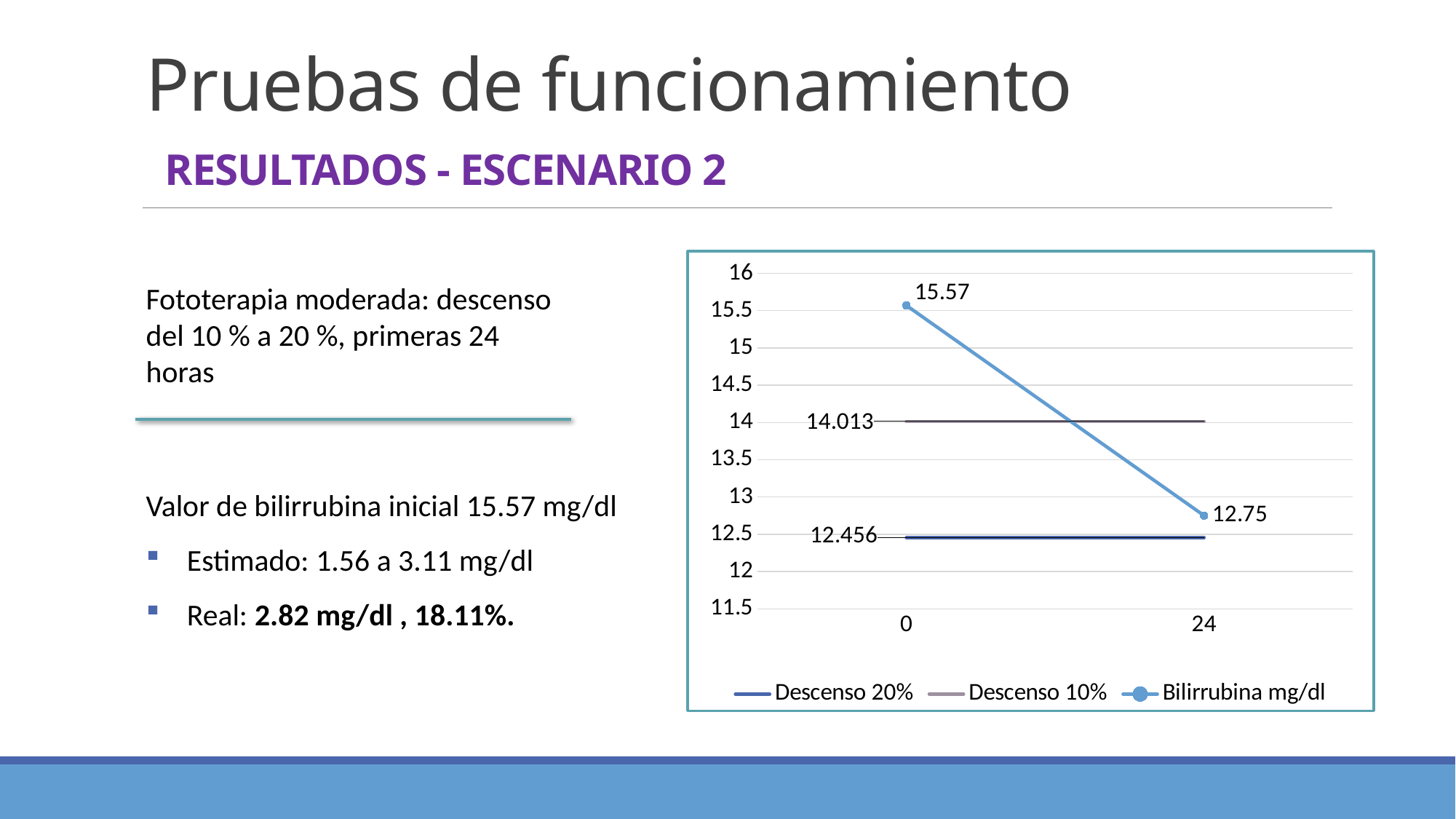
By how much does Bilirrubina mg/dl decrease from hour 0 to hour 24? 2.82 What value is labelled for the Descenso 20% line? 12.456 Which is larger: Bilirrubina mg/dl at hour 24 or the Descenso 20% value? Bilirrubina mg/dl at hour 24 Is the value of Bilirrubina mg/dl at hour 24 greater or less than 13? less What is the value of Bilirrubina mg/dl at hour 24? 12.75 Does the Bilirrubina mg/dl line rise or fall from hour 0 to hour 24? fall How many points are shown on the x axis of the chart? 2 What is the difference between the Descenso 10% value and the Descenso 20% value? 1.557 What kind of chart is shown on the slide? line chart How many series does the chart legend list? 3 What value is labelled for the Descenso 10% line? 14.013 What is the value of Bilirrubina mg/dl at hour 0? 15.57